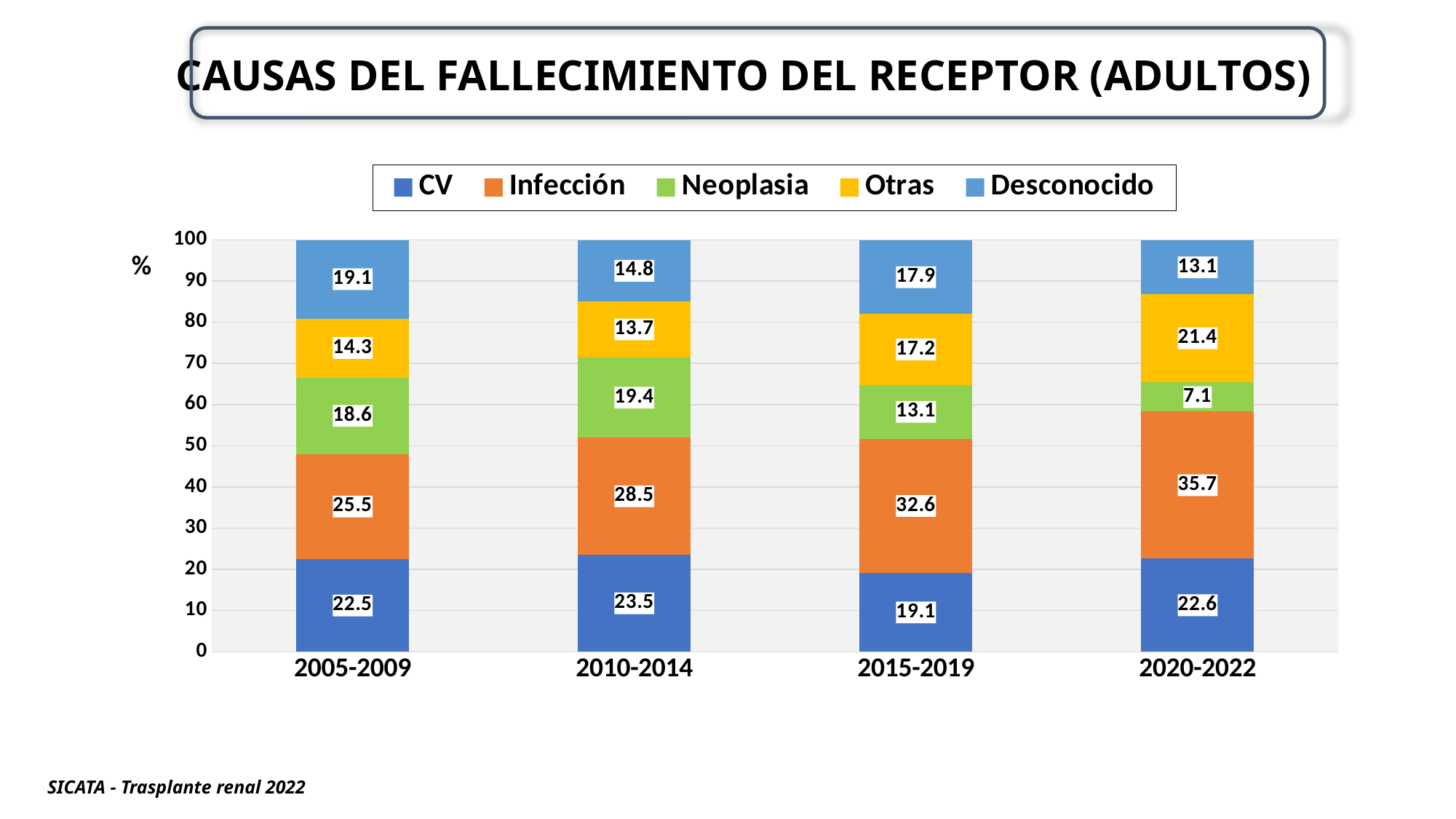
What is the value for Neoplasia in 2010-2014? 19.4 What is the value for Infección in 2020-2022? 35.7 What is the value for Otras in 2015-2019? 17.2 In which period is the Neoplasia value lowest? 2020-2022 Does the Infección value rise or fall across the periods from 2005-2009 to 2020-2022? Rise Which is larger, the CV value in 2010-2014 or the CV value in 2015-2019? 2010-2014 What is the difference between the Infección values for 2020-2022 and 2005-2009? 10.2 In which period is the Infección value highest? 2020-2022 What kind of chart is shown on the slide? Stacked bar chart What is the value for Desconocido in 2005-2009? 19.1 How many series does the legend list? 5 How many periods are shown on the x axis? 4